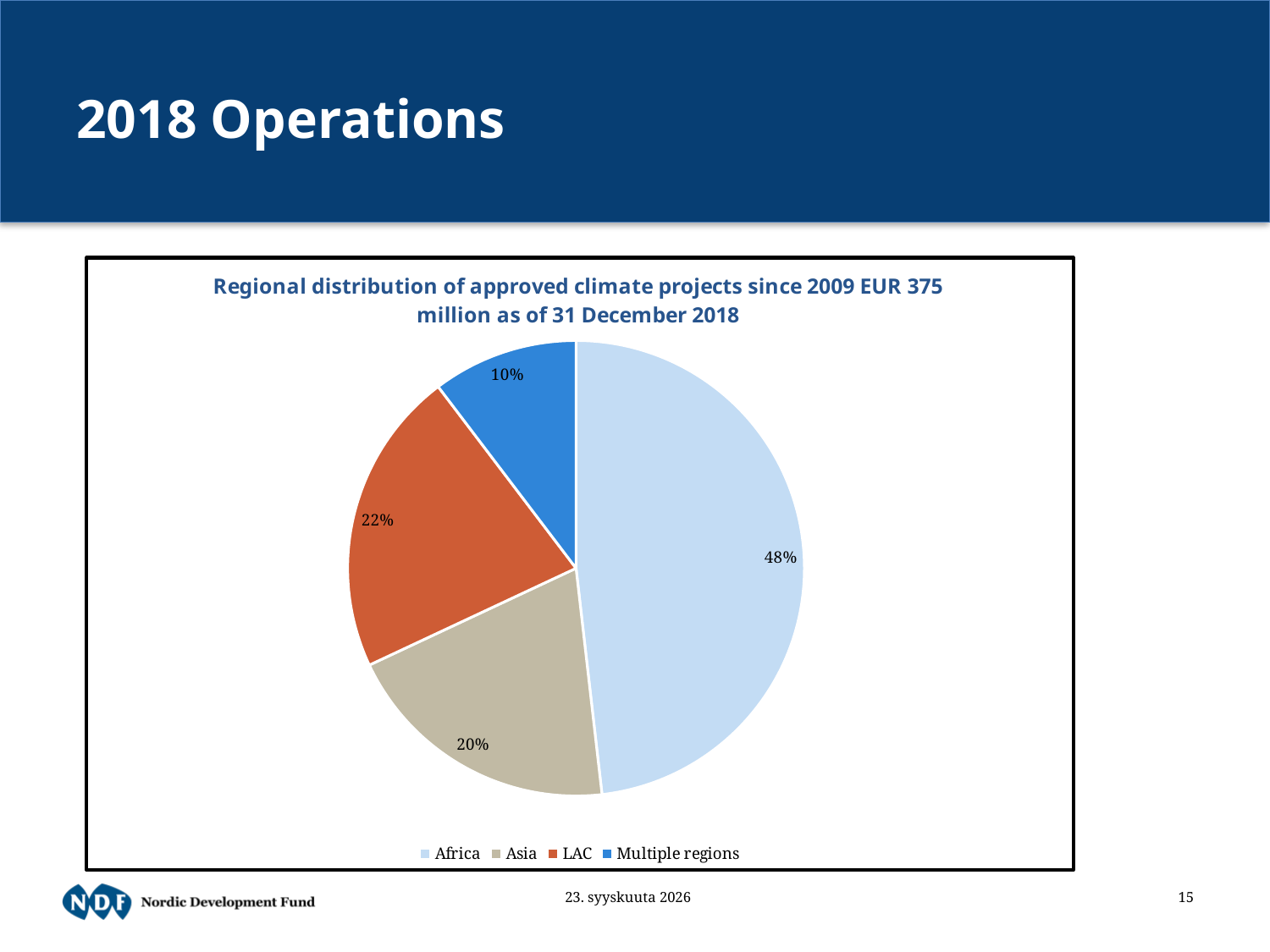
What share of the pie does Africa account for? 48% Which region has the largest share of the pie? Africa What is the title of the chart? Regional distribution of approved climate projects since 2009 EUR 375 million as of 31 December 2018 Which is larger, the share for Asia or the share for Multiple regions? Asia What is the difference in percentage points between the LAC share and the Asia share? 2 What is the difference in percentage points between the Africa share and the LAC share? 26 Which region has the smallest share of the pie? Multiple regions What share of the pie does Asia account for? 20% What share of the pie does LAC account for? 22% How many slices does the pie chart have? 4 What kind of chart is shown on the slide? Pie chart What share of the pie does Multiple regions account for? 10%